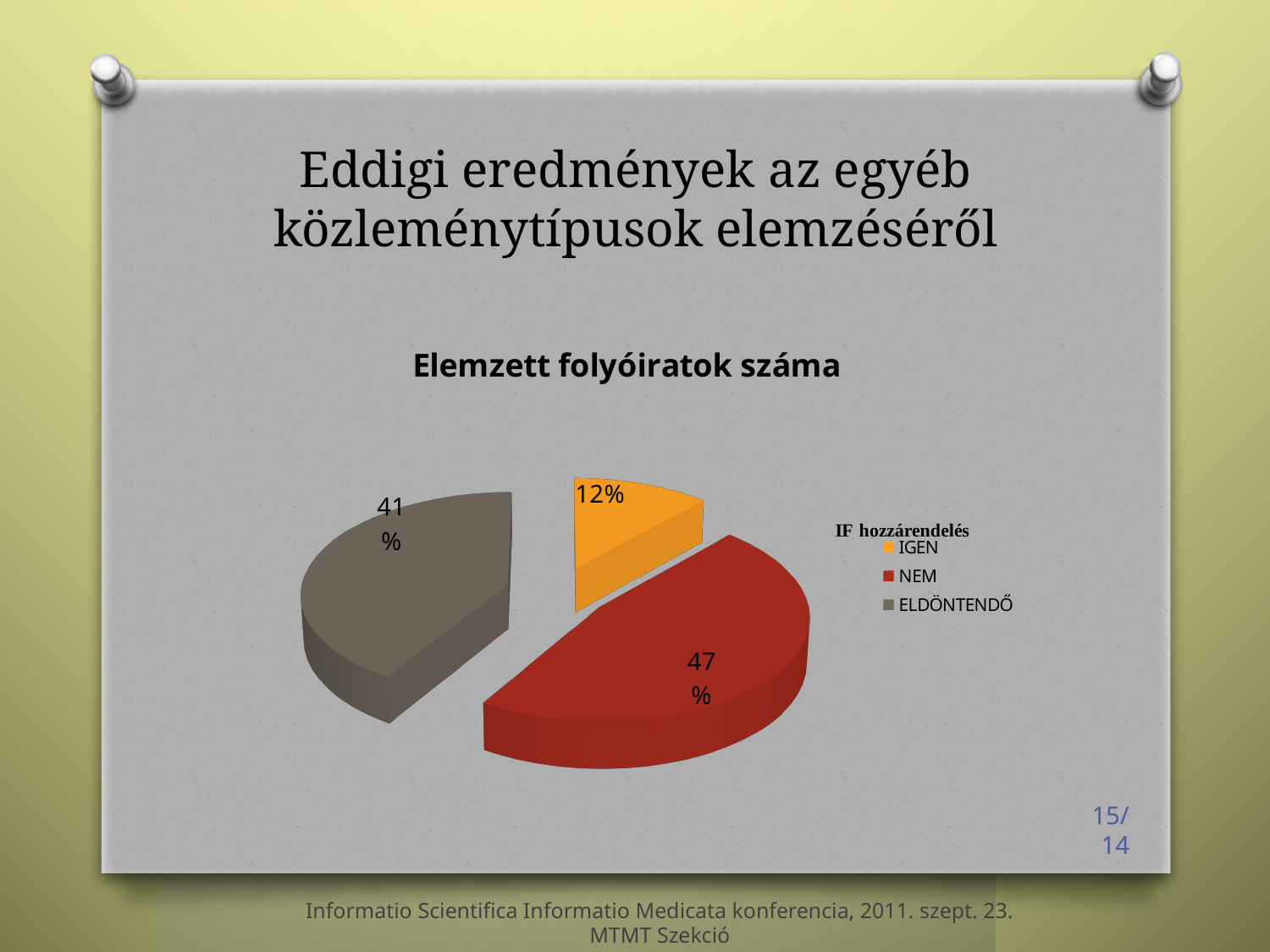
Which category has the smallest slice of the pie? IGEN What is the difference in percentage points between the NEM and ELDÖNTENDŐ slices? 6 What kind of chart is shown on the slide? pie chart Which is larger, the NEM slice or the IGEN slice? NEM Which category has the largest slice of the pie? NEM What is the heading shown above the legend entries? IF hozzárendelés What share of the pie does the ELDÖNTENDŐ slice represent? 41% What share of the pie does the IGEN slice represent? 12% How many categories does the pie chart have? 3 What is the title of the chart? Elemzett folyóiratok száma What share of the pie does the NEM slice represent? 47% What is the difference in percentage points between the ELDÖNTENDŐ and IGEN slices? 29